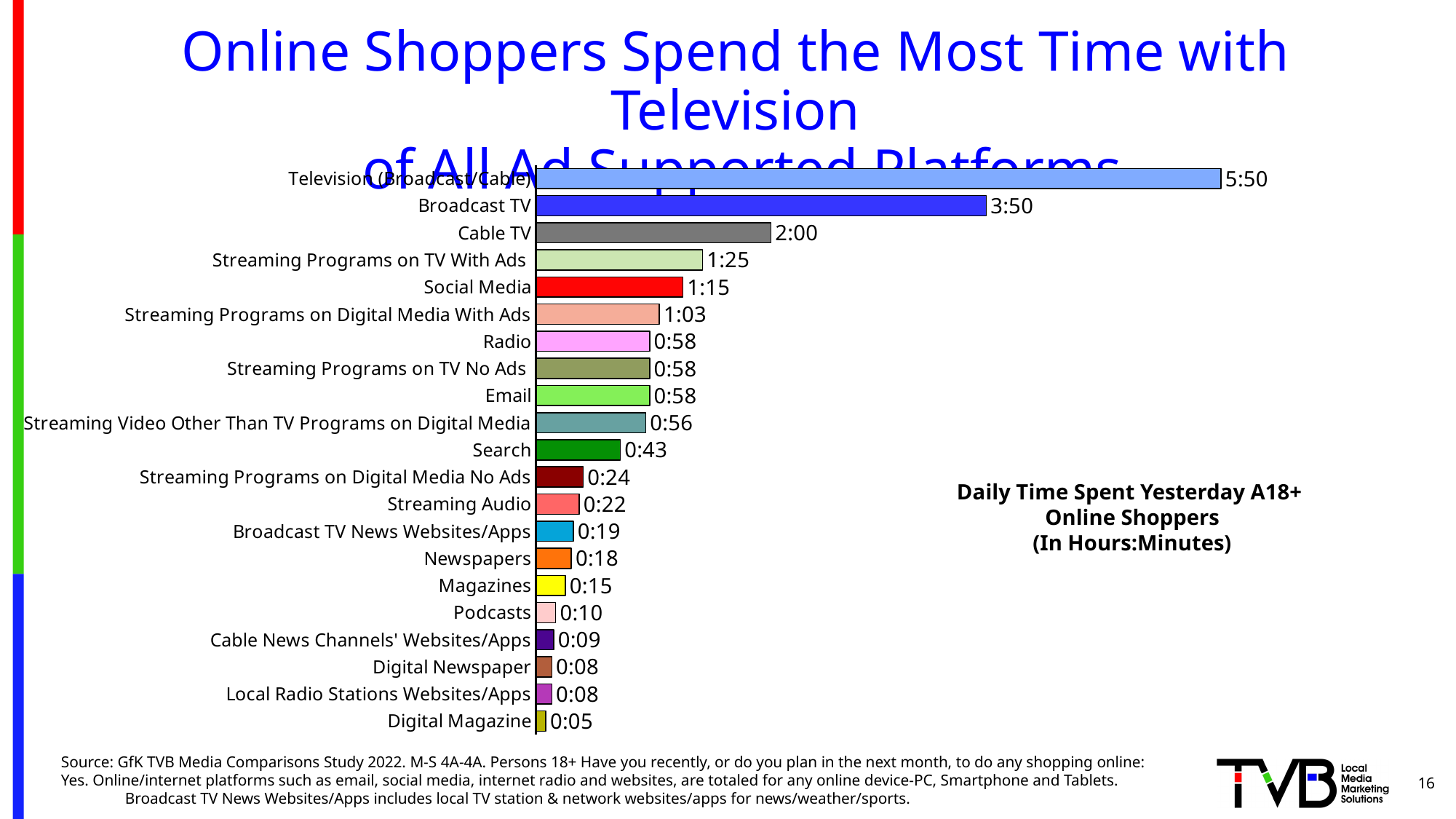
What is the daily time spent with Television (Broadcast/Cable) by online shoppers? 5:50 Which is larger, the value for Social Media or the value for Streaming Programs on TV With Ads? Streaming Programs on TV With Ads Which category has the lowest daily time spent? Digital Magazine Which category has the highest daily time spent? Television (Broadcast/Cable) What is the difference between Newspapers and Magazines in hours:minutes? 0:03 What is the value shown for Search? 0:43 How many categories are shown in the chart? 21 What is the value shown for Social Media? 1:15 What is the difference between Broadcast TV and Cable TV in hours:minutes? 1:50 What kind of chart is shown on the slide? Bar chart What is the value shown for Podcasts? 0:10 In what units are the chart values expressed, according to the chart's label? Hours:Minutes